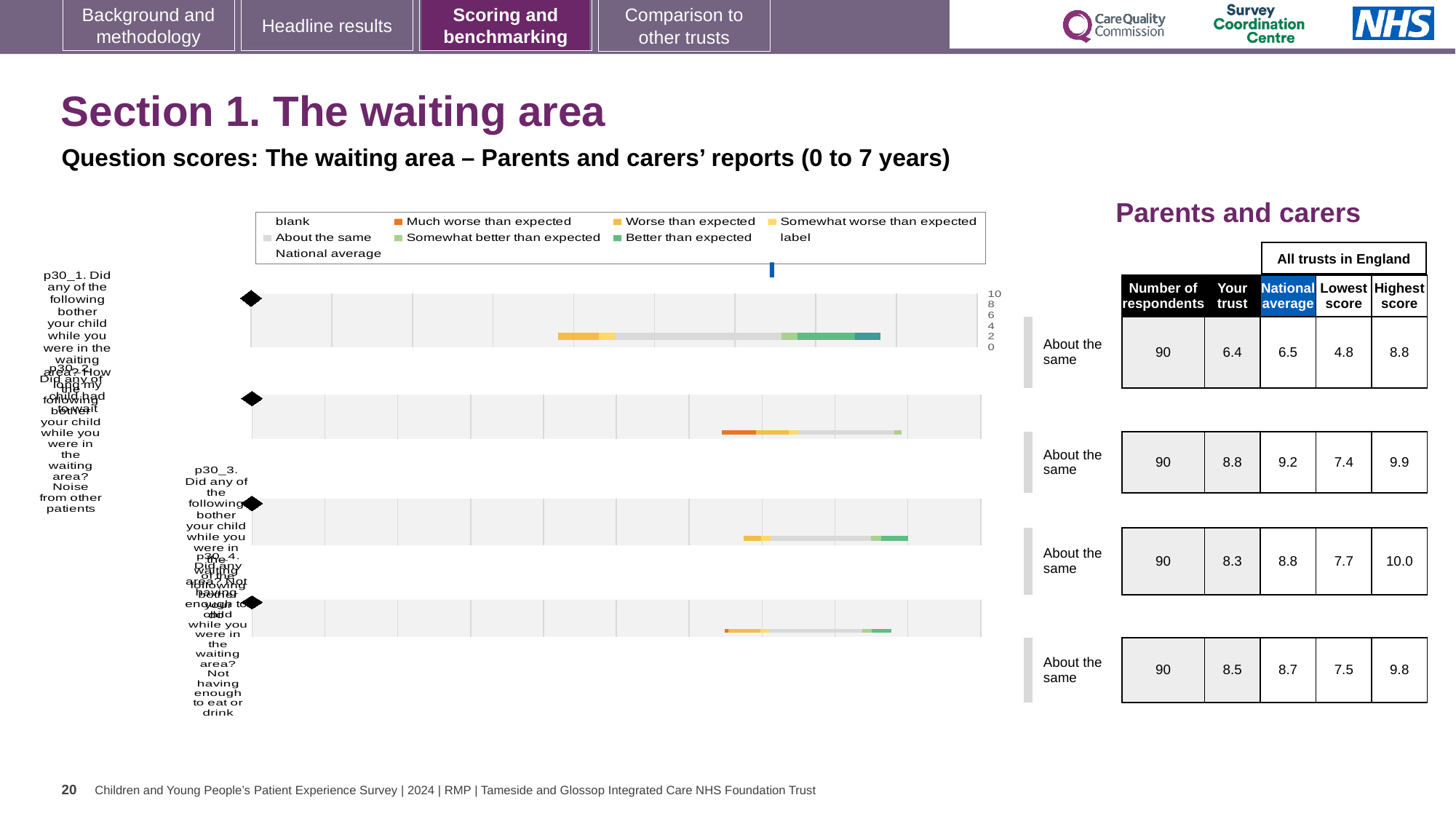
Which legend entry is shown in orange in the chart? Much worse than expected How many horizontal bars (questions) are plotted in the chart? 4 What is the national average score for the first question row (p30_1)? 6.5 What is the difference between the national average and 'Your trust' score for the second question row (p30_2)? 0.4 What is the lowest score across all trusts in England for the fourth question row (p30_4)? 7.5 What is the 'Your trust' score for the second question row (p30_2)? 8.8 What kind of chart is shown on the slide? bar chart How many entries does the chart legend list? 9 What is the 'Your trust' score for the first question row (p30_1, waiting area)? 6.4 Which question row has the lowest 'Your trust' score? p30_1 (first row) What is the highest score across all trusts in England for the third question row (p30_3)? 10.0 How many respondents are reported for each question row? 90